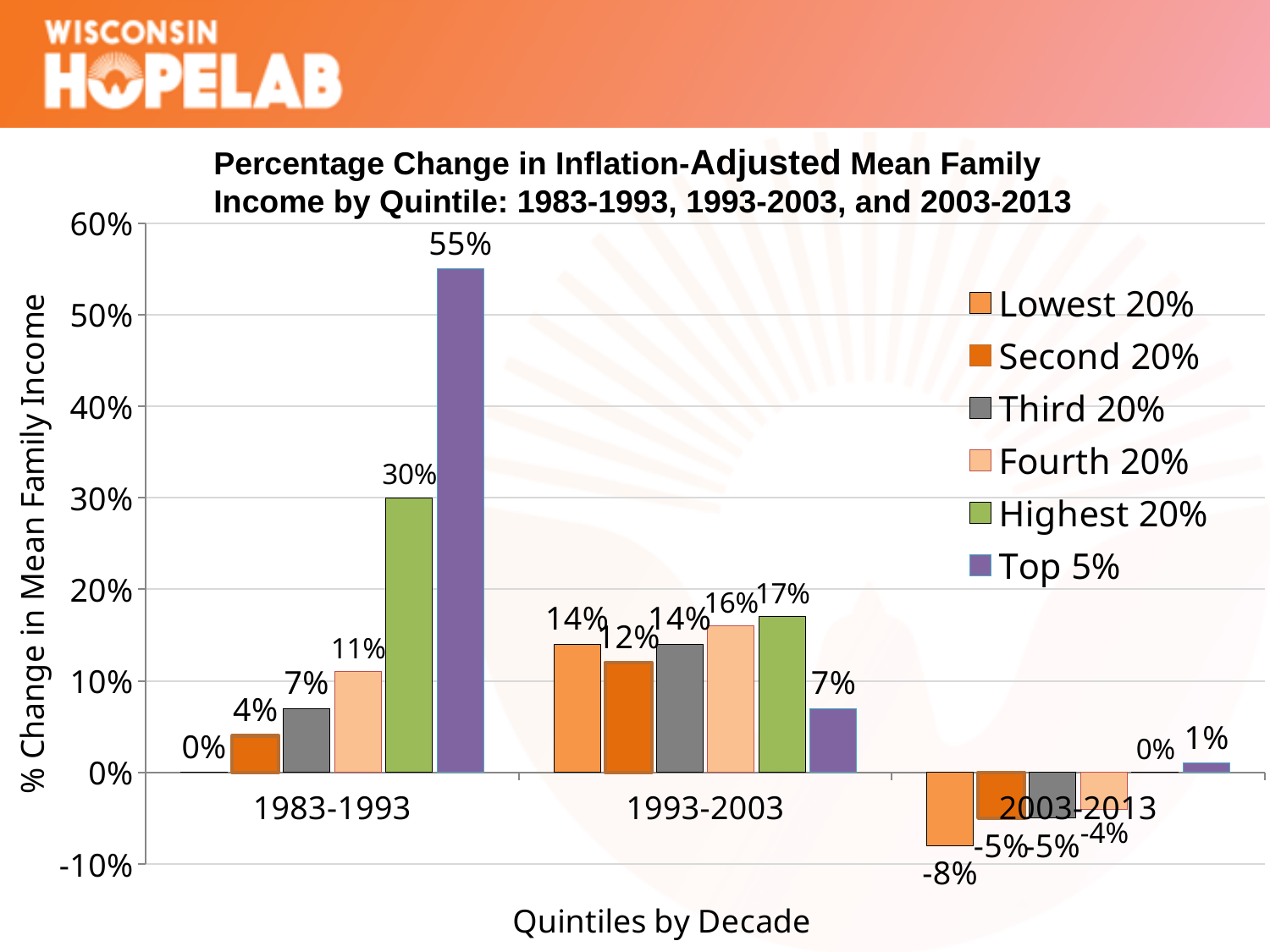
What is the value for Fourth 20% in 2003-2013? -4% Which quintile group has the highest value in 1983-1993? Top 5% What is the value for Top 5% in 1983-1993? 55% How many decade categories are shown on the x axis? 3 Which quintile group has the lowest value in 1993-2003? Top 5% What kind of chart is this? Bar chart What is the difference between the Top 5% and Highest 20% values in 1983-1993? 25 percentage points Which is larger: the Lowest 20% value in 1993-2003 or the Lowest 20% value in 1983-1993? 1993-2003 What is the value for Lowest 20% in 2003-2013? -8% Does the Top 5% value rise or fall across the three decades from 1983-1993 to 2003-2013? Fall How many series does the legend list? 6 What is the value for Highest 20% in 1983-1993? 30%